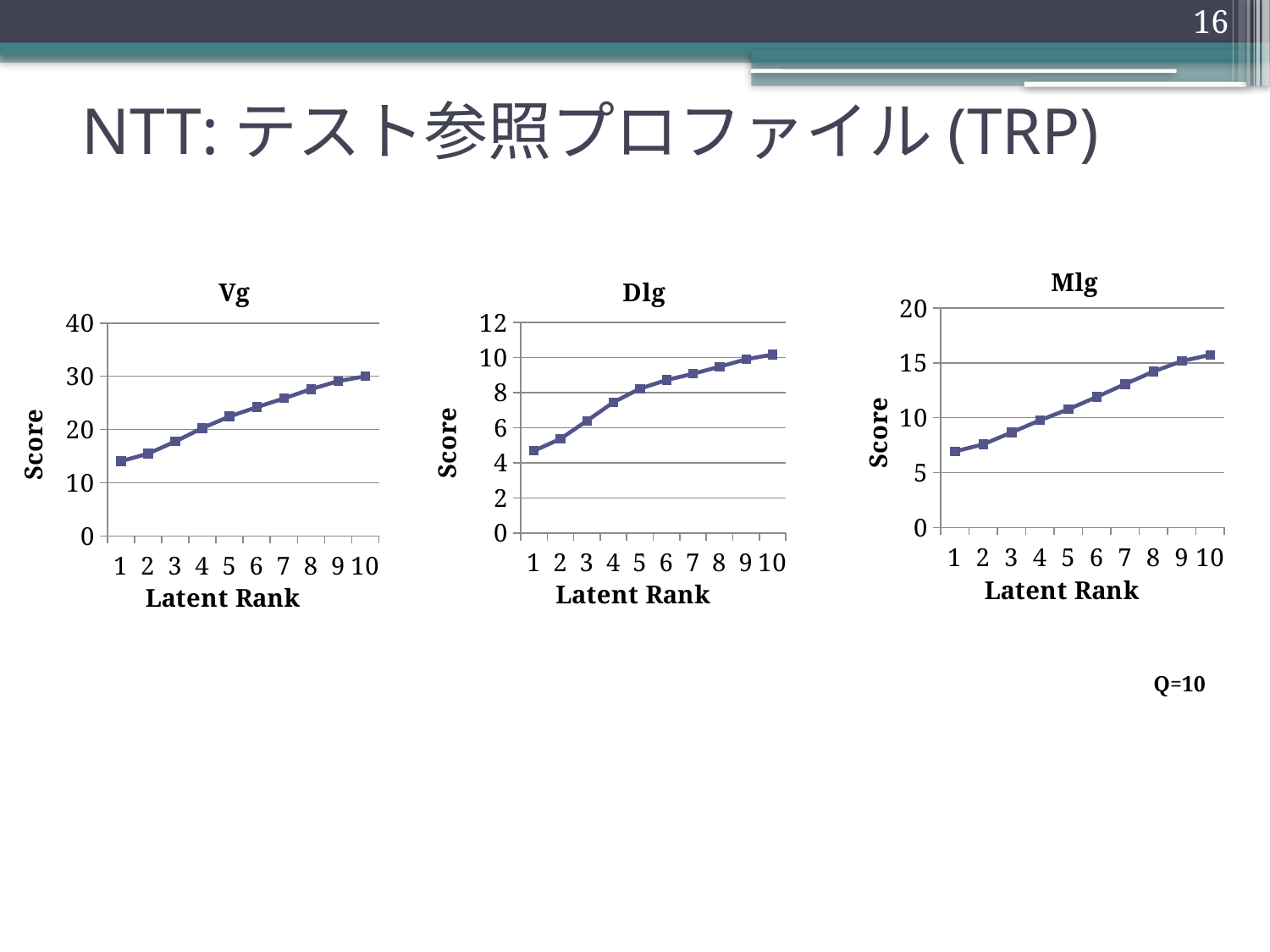
What is the label of the x axis on the Dlg chart? Latent Rank In the Vg chart, is the score for latent rank 8 greater or less than 30? less In the Dlg chart, is the score for latent rank 7 greater or less than 10? less In the Dlg chart, which latent rank has the highest score? 10 In the Mlg chart, is the score for latent rank 10 greater or less than 15? greater In the Vg chart, do the scores rise or fall as latent rank increases from 1 to 10? rise What kind of chart is the Vg chart? line chart How many latent rank points are plotted in the Mlg chart? 10 In the Mlg chart, which latent rank has the lowest score? 1